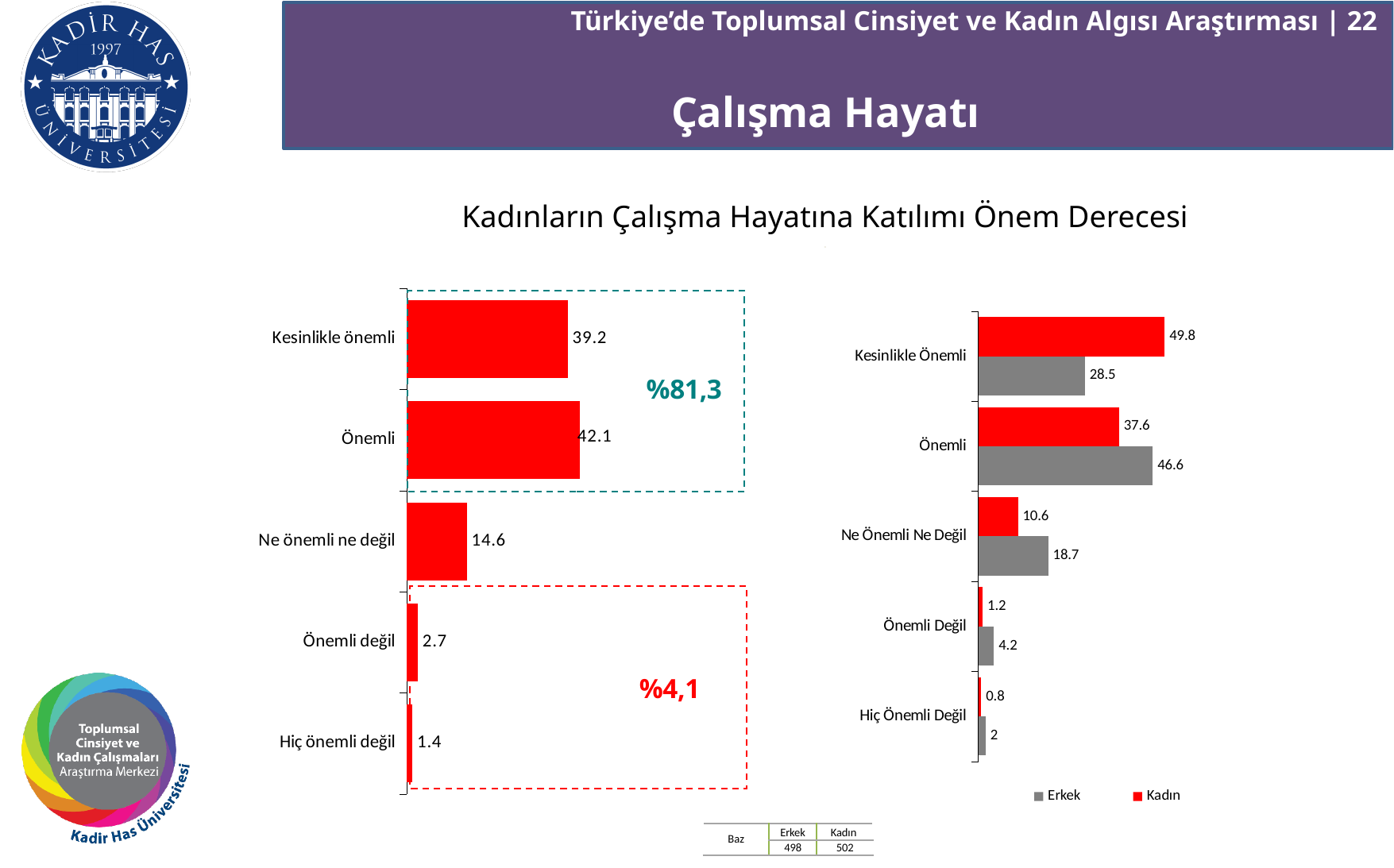
In the right chart, what is the Kadın value for Kesinlikle Önemli? 49.8 How many series does the legend of the right chart list? 2 In the left chart, what is the value for Ne önemli ne değil? 14.6 In the right chart, which is larger for Ne Önemli Ne Değil, Erkek or Kadın? Erkek How many categories does the left chart show? 5 In the right chart, what is the difference between the Kadın and Erkek values for Kesinlikle Önemli? 21.3 What type of chart is the right chart? Bar chart In the left chart, which category has the highest value? Önemli In the left chart, what is the difference between the values for Önemli and Kesinlikle önemli? 2.9 In the left chart, what is the value for Önemli? 42.1 In the left chart, which category has the lowest value? Hiç önemli değil In the right chart, what is the Erkek value for Önemli? 46.6